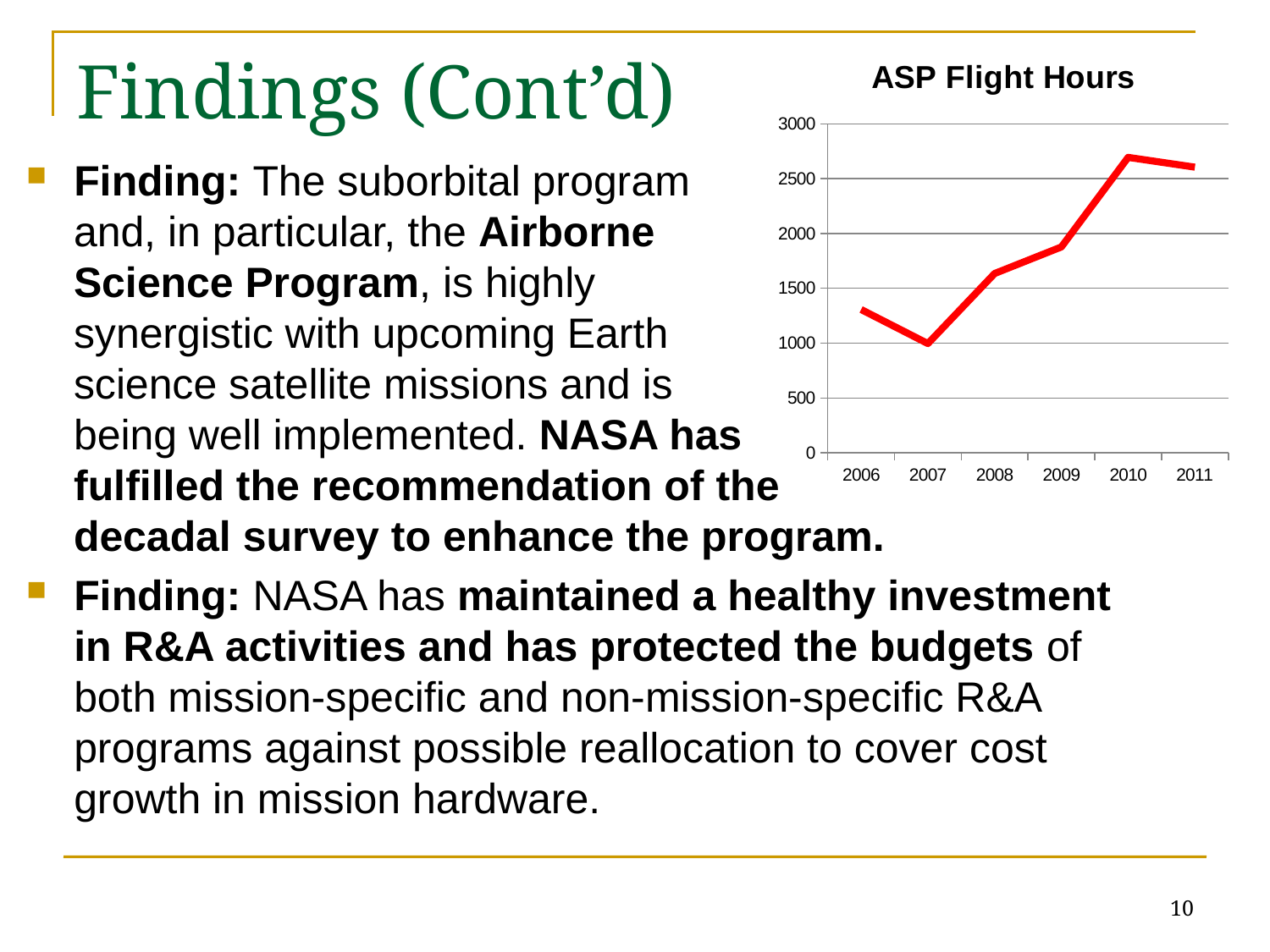
Is the value for 2010 greater or less than 2500? greater Is the value for 2006 greater or less than 1000? greater Is the value for 2011 greater or less than 2500? greater Which year has more ASP flight hours, 2006 or 2008? 2008 Which year has the highest ASP flight hours? 2010 Do ASP flight hours generally rise or fall from 2007 to 2010? rise Which year has the lowest ASP flight hours? 2007 What kind of chart is shown on the slide? line chart Which year has more ASP flight hours, 2007 or 2009? 2009 What is the title of the chart? ASP Flight Hours How many years are plotted on the x axis of the chart? 6